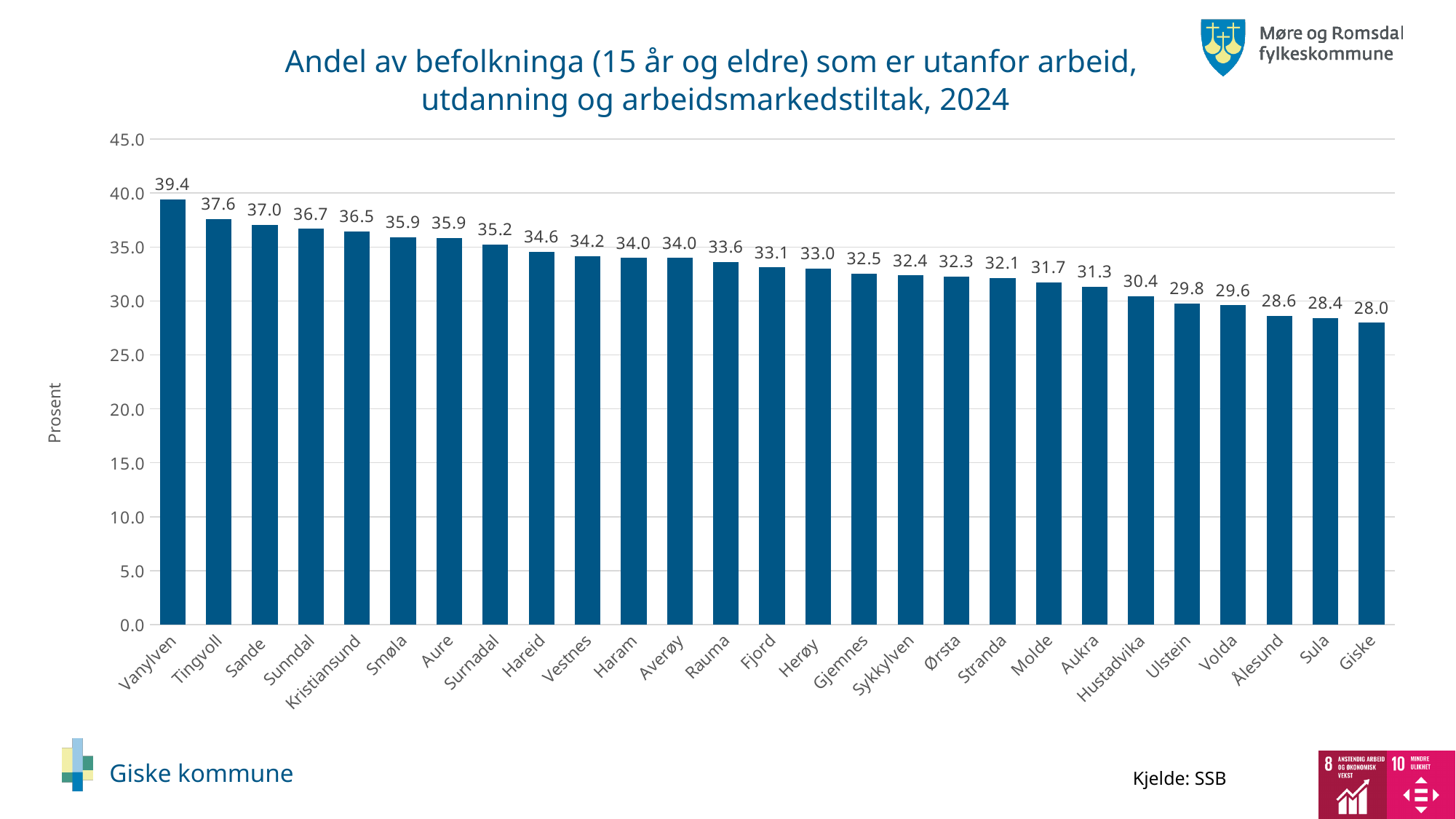
Which municipality has the highest value? Vanylven Which has a larger value, Tingvoll or Sula? Tingvoll Which municipality has the lowest value? Giske What kind of chart is shown on the slide? Bar chart How many municipalities are shown in the chart? 27 What is the value for Vanylven? 39.4 Is the value for Hustadvika greater or less than 35.0? less What is the value for Molde? 31.7 What is the value for Ålesund? 28.6 What is the difference between the values for Vanylven and Giske? 11.4 What is the label of the vertical axis? Prosent What is the value for Giske? 28.0